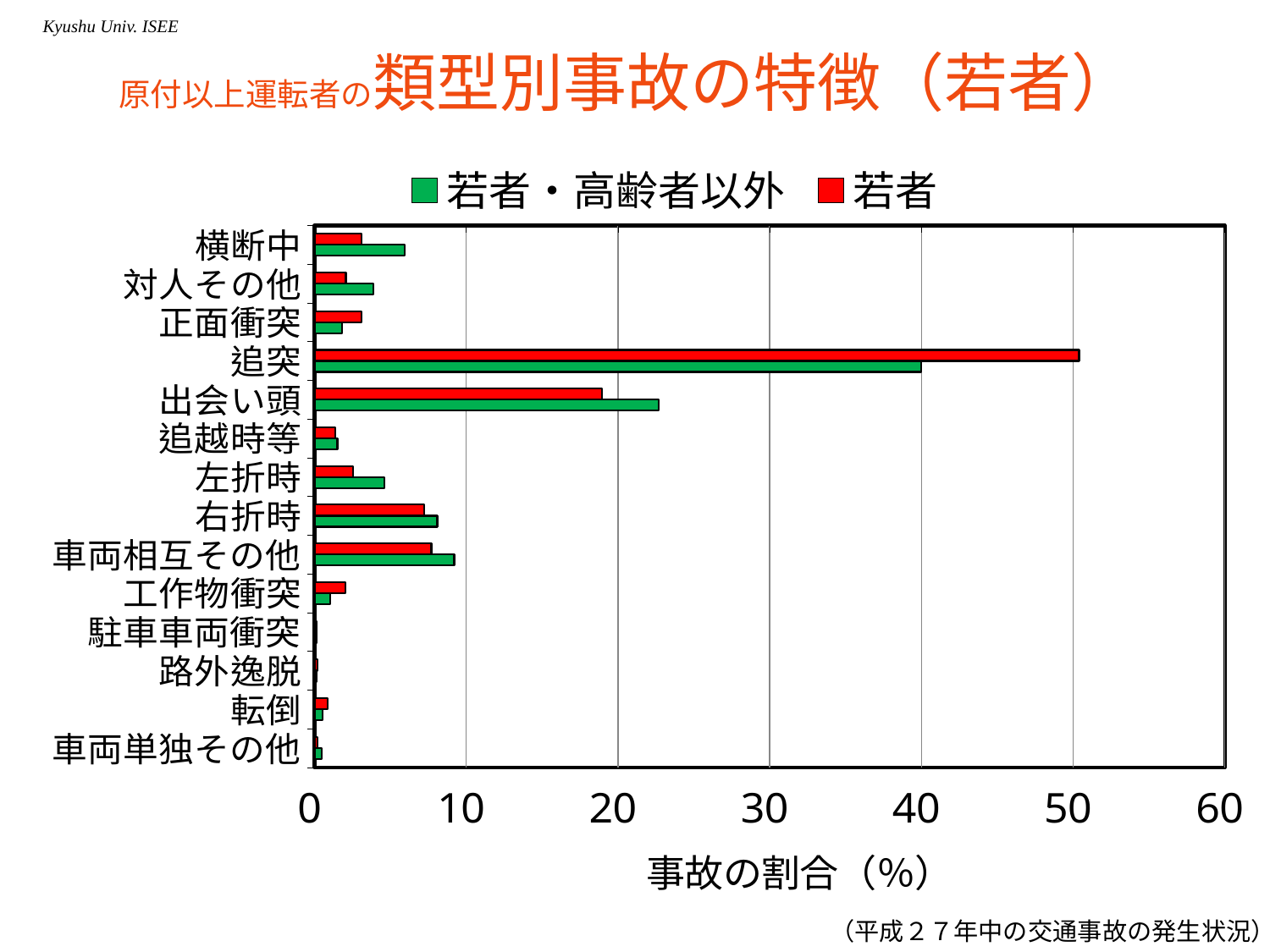
Is the 若者 value for 出会い頭 greater or less than 20? less Is the 若者・高齢者以外 value for 出会い頭 greater or less than 20? greater How many series does the legend list? 2 For 横断中, which series has the larger value: 若者 or 若者・高齢者以外? 若者・高齢者以外 What kind of chart is shown on the slide? bar chart Is the 若者 value for 追突 greater or less than 40? greater For the 若者 series, which is larger: 追突 or 出会い頭? 追突 What is the title of the x axis? 事故の割合（%） How many accident-type categories are plotted on the y axis? 14 Which category has the highest value for the 若者・高齢者以外 series? 追突 For 工作物衝突, which series has the larger value: 若者 or 若者・高齢者以外? 若者 Which category has the highest value for the 若者 series? 追突